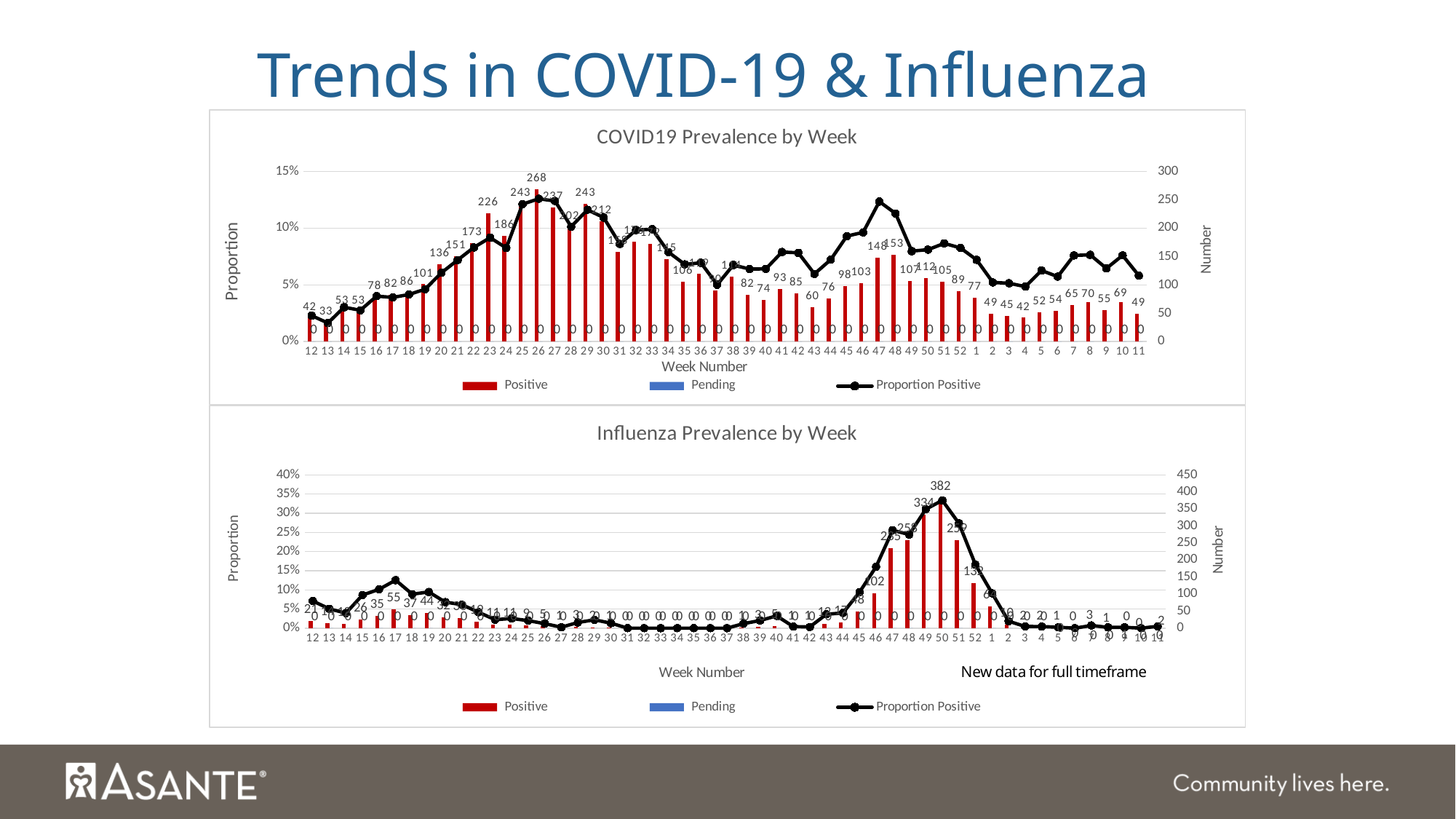
In the COVID19 Prevalence by Week chart, which week has more positives, week 29 or week 30? Week 29 In the COVID19 Prevalence by Week chart, how many positives are shown for week 23? 226 In the Influenza Prevalence by Week chart, which week has the highest number of positives? Week 50 In the Influenza Prevalence by Week chart, how many positives are shown for week 49? 334 In the COVID19 Prevalence by Week chart, what is the difference in positives between week 26 and week 25? 25 In the COVID19 Prevalence by Week chart, how many positives are shown for week 26? 268 In the COVID19 Prevalence by Week chart, which week has the highest number of positives? Week 26 What kind of chart is the COVID19 Prevalence by Week chart? Combined bar and line chart In the Influenza Prevalence by Week chart, what is the difference in positives between week 50 and week 49? 48 In the COVID19 Prevalence by Week chart, which week has the lowest number of positives? Week 13 In the Influenza Prevalence by Week chart, is the Proportion Positive at week 50 greater or less than 30%? greater How many series does the legend of the Influenza Prevalence by Week chart list? 3